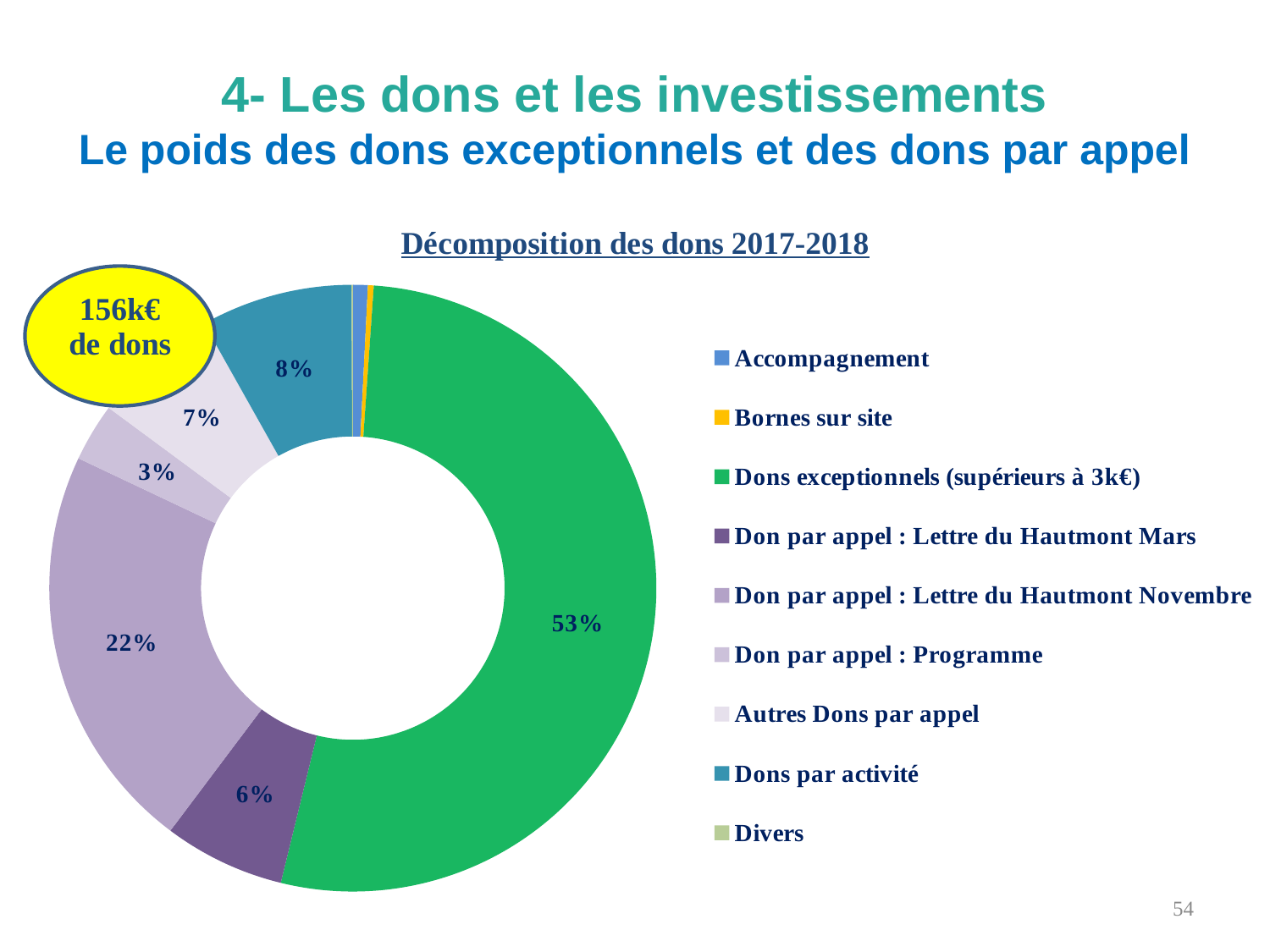
What share of the donations is 'Don par appel : Lettre du Hautmont Novembre'? 22% What type of chart is shown on the slide? Doughnut (pie) chart What is the title of the chart? Décomposition des dons 2017-2018 What share of the donations is 'Dons par activité'? 8% Which is larger: the share for 'Don par appel : Lettre du Hautmont Novembre' or for 'Dons par activité'? Don par appel : Lettre du Hautmont Novembre What is the difference in percentage points between the share for 'Dons exceptionnels (supérieurs à 3k€)' and the share for 'Don par appel : Lettre du Hautmont Novembre'? 31 percentage points What share of the donations is 'Autres Dons par appel'? 7% Which category has the largest share of the donations? Dons exceptionnels (supérieurs à 3k€) How many entries does the chart legend list? 9 What share of the donations is 'Dons exceptionnels (supérieurs à 3k€)'? 53% What share of the donations is 'Don par appel : Lettre du Hautmont Mars'? 6% What share of the donations is 'Don par appel : Programme'? 3%